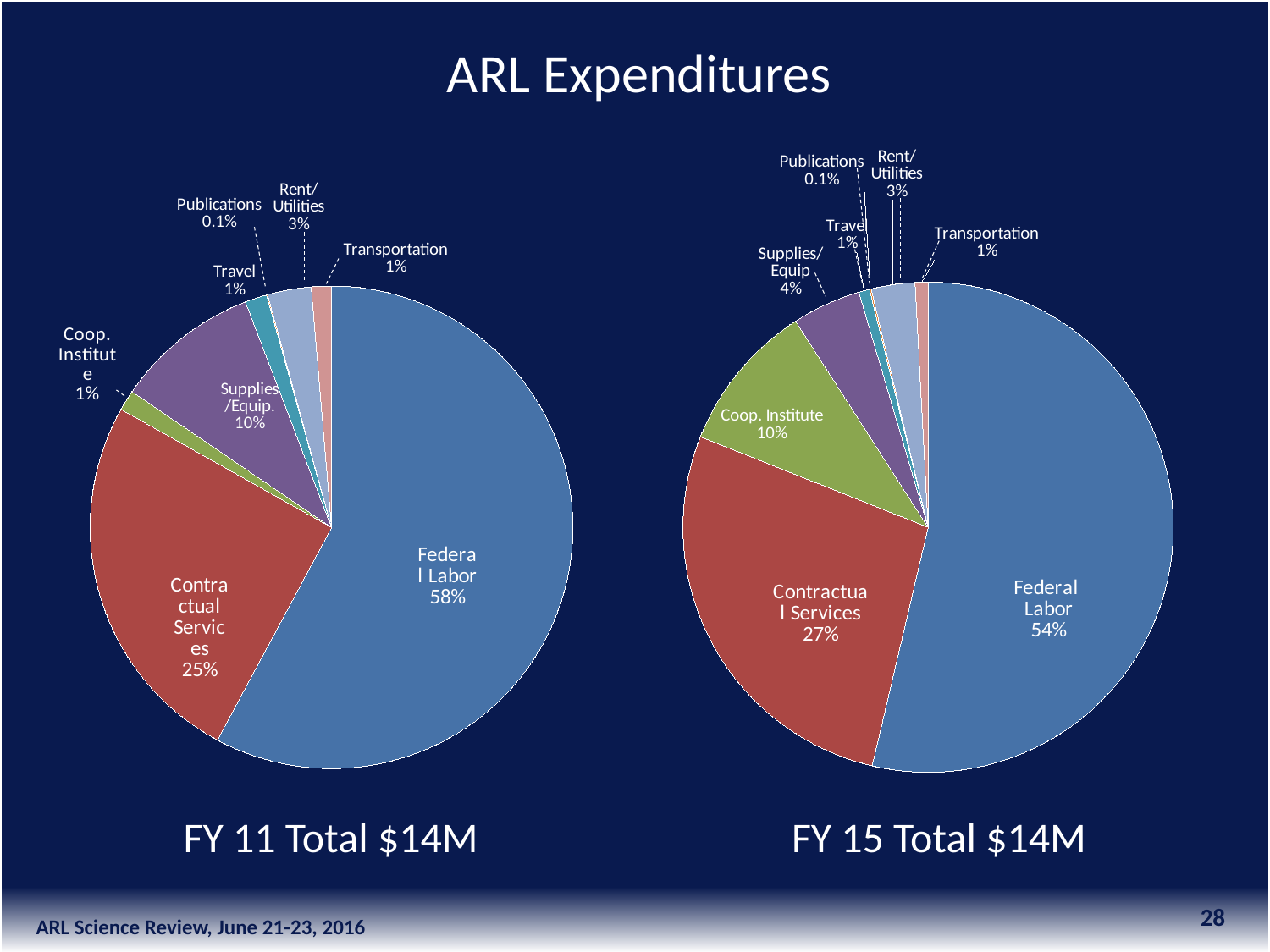
What is the title of the slide containing the two pie charts? ARL Expenditures In the FY 11 pie chart, which category has the largest share? Federal Labor What is the difference between the Federal Labor share in FY 11 and in FY 15? 4 percentage points In the FY 11 pie chart, what share of expenditures is Supplies/Equip.? 10% What kind of chart is used to show the FY 11 expenditures? Pie chart In the FY 15 pie chart, what share of expenditures is Contractual Services? 27% In the FY 11 pie chart, what share of expenditures is Federal Labor? 58% Which is larger: the Contractual Services share in FY 11 or in FY 15? FY 15 In the FY 15 pie chart, what share of expenditures is Coop. Institute? 10% How many categories are shown in the FY 15 pie chart? 8 In the FY 15 pie chart, which category has the smallest share? Publications What is the total expenditure shown for FY 15? $14M